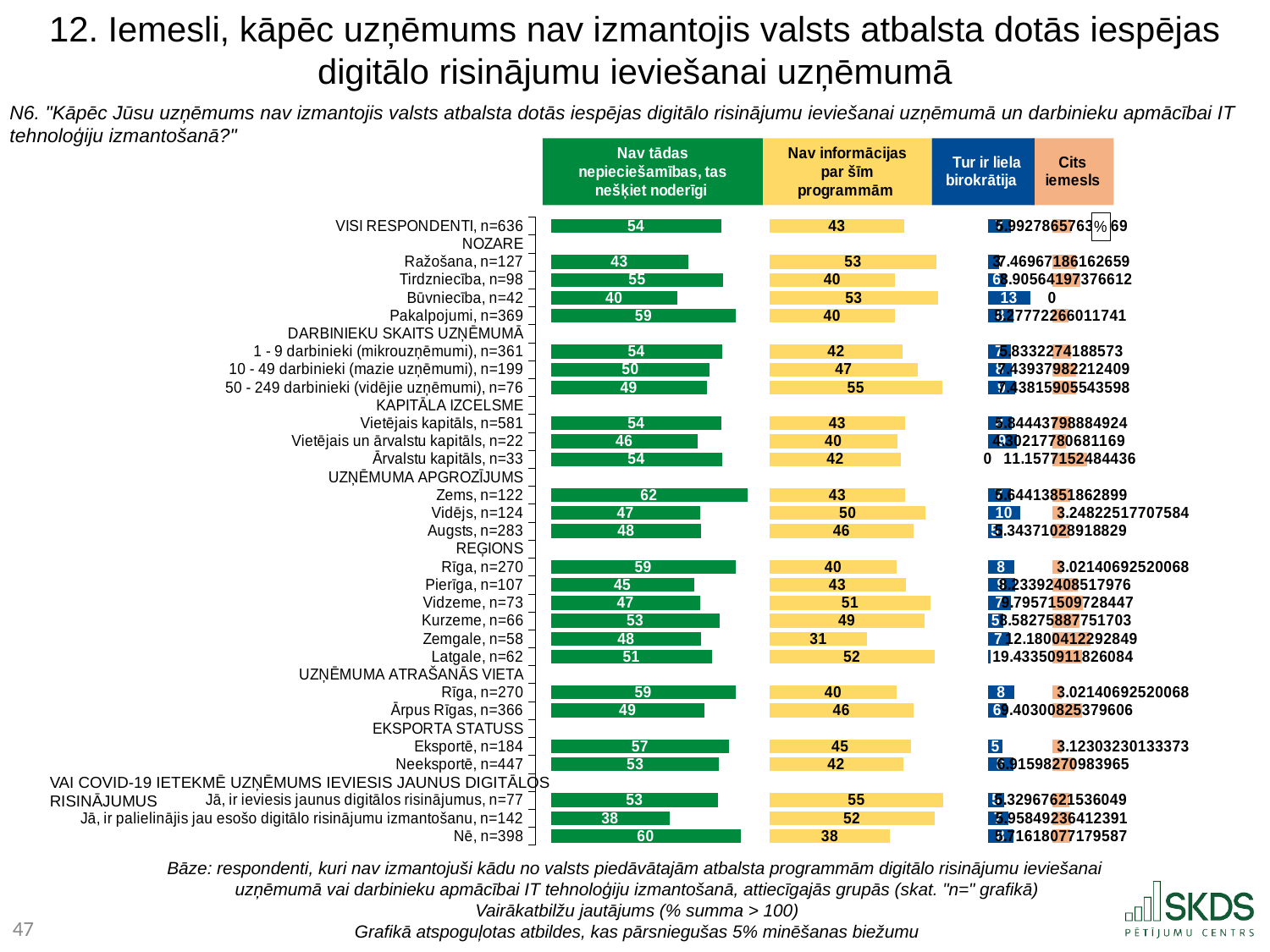
What is the value for "Nav informācijas par šīm programmām" in the Būvniecība, n=42 row? 53 Which row has the highest value for "Nav tādas nepieciešamības, tas nešķiet noderīgi"? Zems, n=122 For Ražošana, n=127, which is larger: "Nav tādas nepieciešamības, tas nešķiet noderīgi" or "Nav informācijas par šīm programmām"? Nav informācijas par šīm programmām Which row has the lowest value for "Nav informācijas par šīm programmām"? Zemgale, n=58 What kind of chart is shown on the slide? Bar chart What is the value for "Tur ir liela birokrātija" in the Būvniecība, n=42 row? 13 What percentage of all respondents (VISI RESPONDENTI, n=636) chose "Nav tādas nepieciešamības, tas nešķiet noderīgi"? 54 What colour are the bars for "Nav informācijas par šīm programmām"? Yellow How many series does the chart legend list? 4 What is the difference between the "Nav tādas nepieciešamības, tas nešķiet noderīgi" value and the "Nav informācijas par šīm programmām" value for Nē, n=398? 22 Which row has the lowest value for "Nav tādas nepieciešamības, tas nešķiet noderīgi"? Jā, ir palielinājis jau esošo digitālo risinājumu izmantošanu, n=142 What is the value for "Nav informācijas par šīm programmām" in the Zemgale, n=58 row? 31